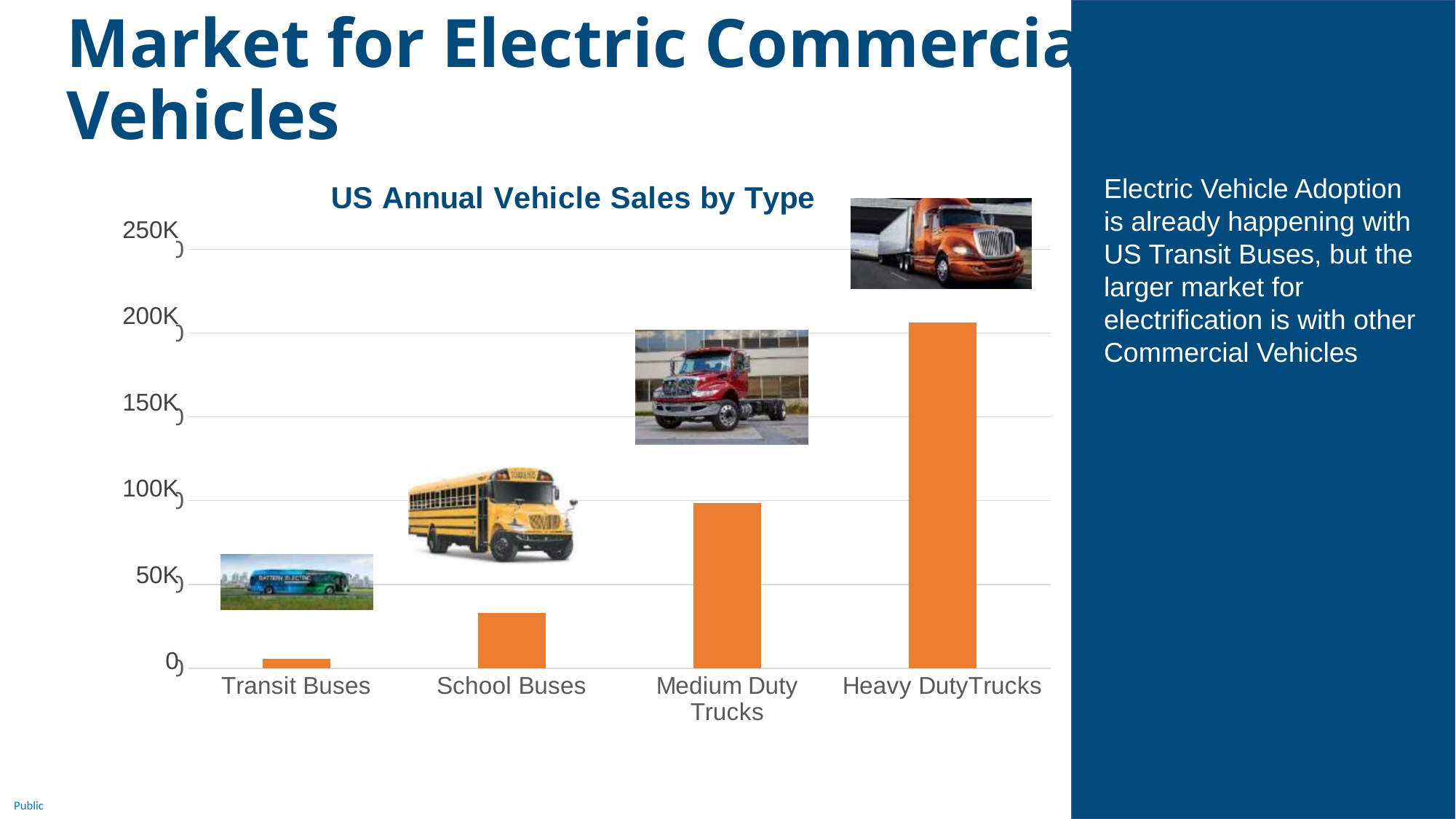
How many vehicle types are shown on the chart? 4 Is the value for Heavy Duty Trucks greater or less than 150K? greater Do the bar values rise or fall from left to right across the vehicle types? Rise Is the value for Transit Buses greater or less than 50K? less What is the title of the chart? US Annual Vehicle Sales by Type What type of chart is shown on the slide? Bar chart Which has higher annual sales, Transit Buses or School Buses? School Buses Which has higher annual sales, School Buses or Medium Duty Trucks? Medium Duty Trucks Is the value for Medium Duty Trucks greater or less than 50K? greater Which vehicle type has the lowest annual sales? Transit Buses Which vehicle type has the highest annual sales? Heavy Duty Trucks